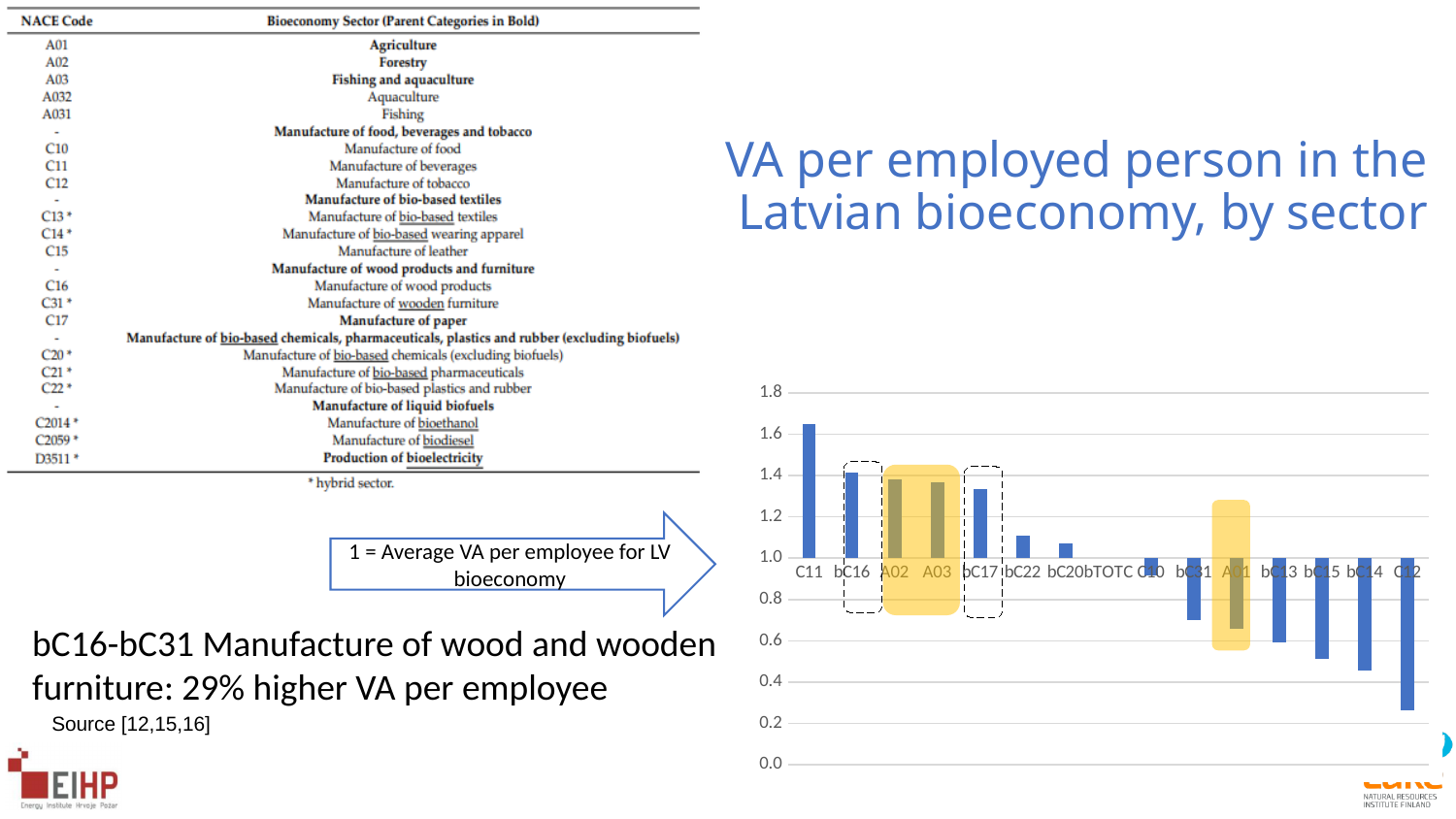
Which sector has the lowest VA per employed person in the chart? C12 Is the value for C11 greater or less than 1.4? greater Which has a higher value, bC22 or bC15? bC22 Do the bar values generally rise or fall from left to right along the x axis? fall Is the value for C12 greater or less than 0.4? less Is the value for bC17 greater or less than 1.2? greater What kind of chart is shown on the slide? bar chart Which sector has the highest VA per employed person in the chart? C11 Which has a higher value, C11 or bC17? C11